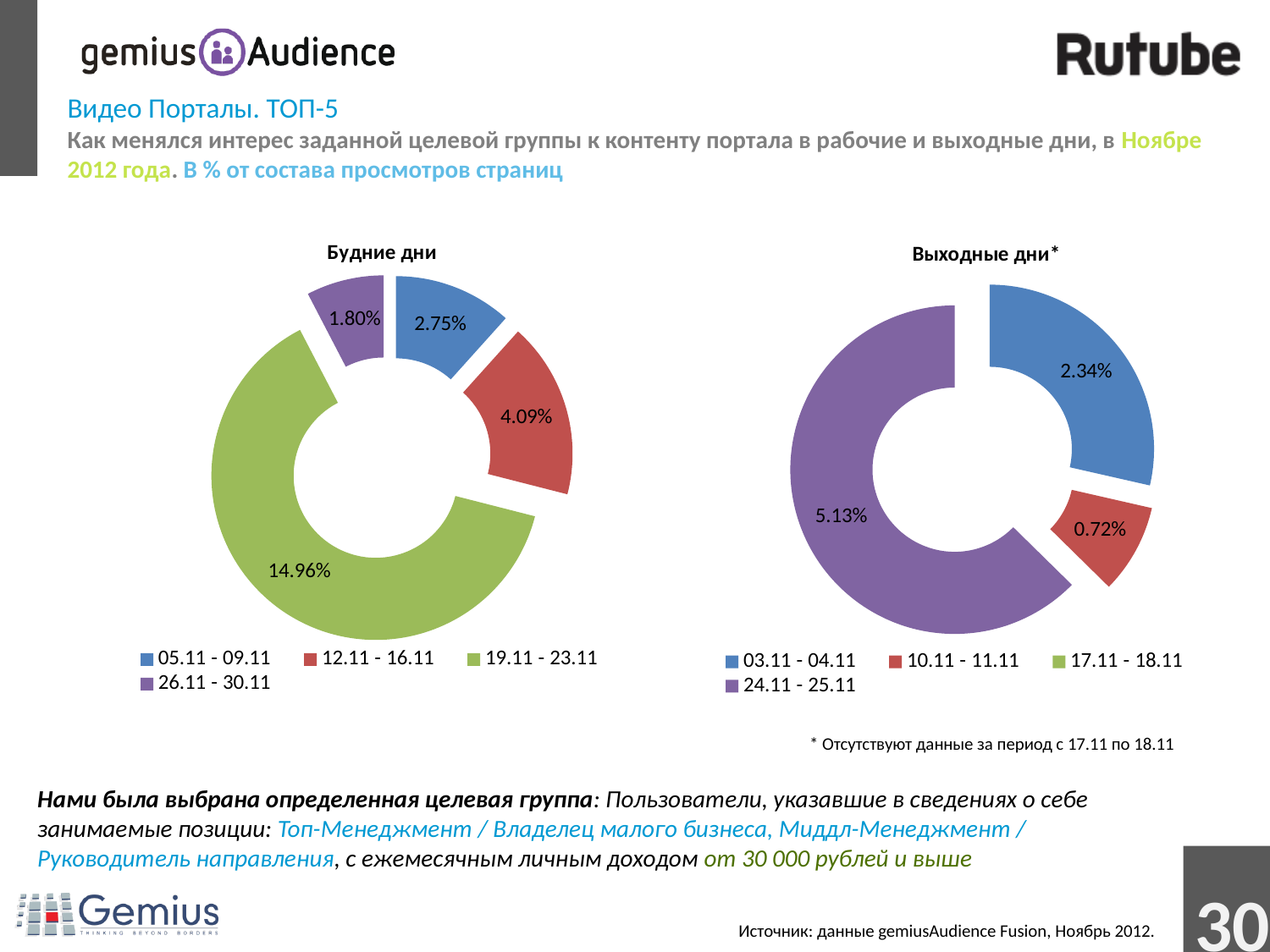
In the 'Будние дни' chart, what is the value for 19.11 - 23.11? 14.96% In the 'Будние дни' chart, what is the difference between the values for 12.11 - 16.11 and 05.11 - 09.11? 1.34% How many entries does the legend of the 'Выходные дни*' chart list? 4 In the 'Выходные дни*' chart, which is larger: the value for 03.11 - 04.11 or for 10.11 - 11.11? 03.11 - 04.11 What kind of chart is the 'Будние дни' chart? Doughnut (pie) chart In the 'Выходные дни*' chart, what is the value for 10.11 - 11.11? 0.72% In the 'Будние дни' chart, which period has the highest value? 19.11 - 23.11 In the 'Будние дни' chart, which period has the lowest value? 26.11 - 30.11 In the 'Выходные дни*' chart, what is the value for 24.11 - 25.11? 5.13% In the 'Будние дни' chart, what colour is the 19.11 - 23.11 segment? Green In the 'Выходные дни*' chart, which period has the highest value? 24.11 - 25.11 In the 'Будние дни' chart, what is the value for 26.11 - 30.11? 1.80%